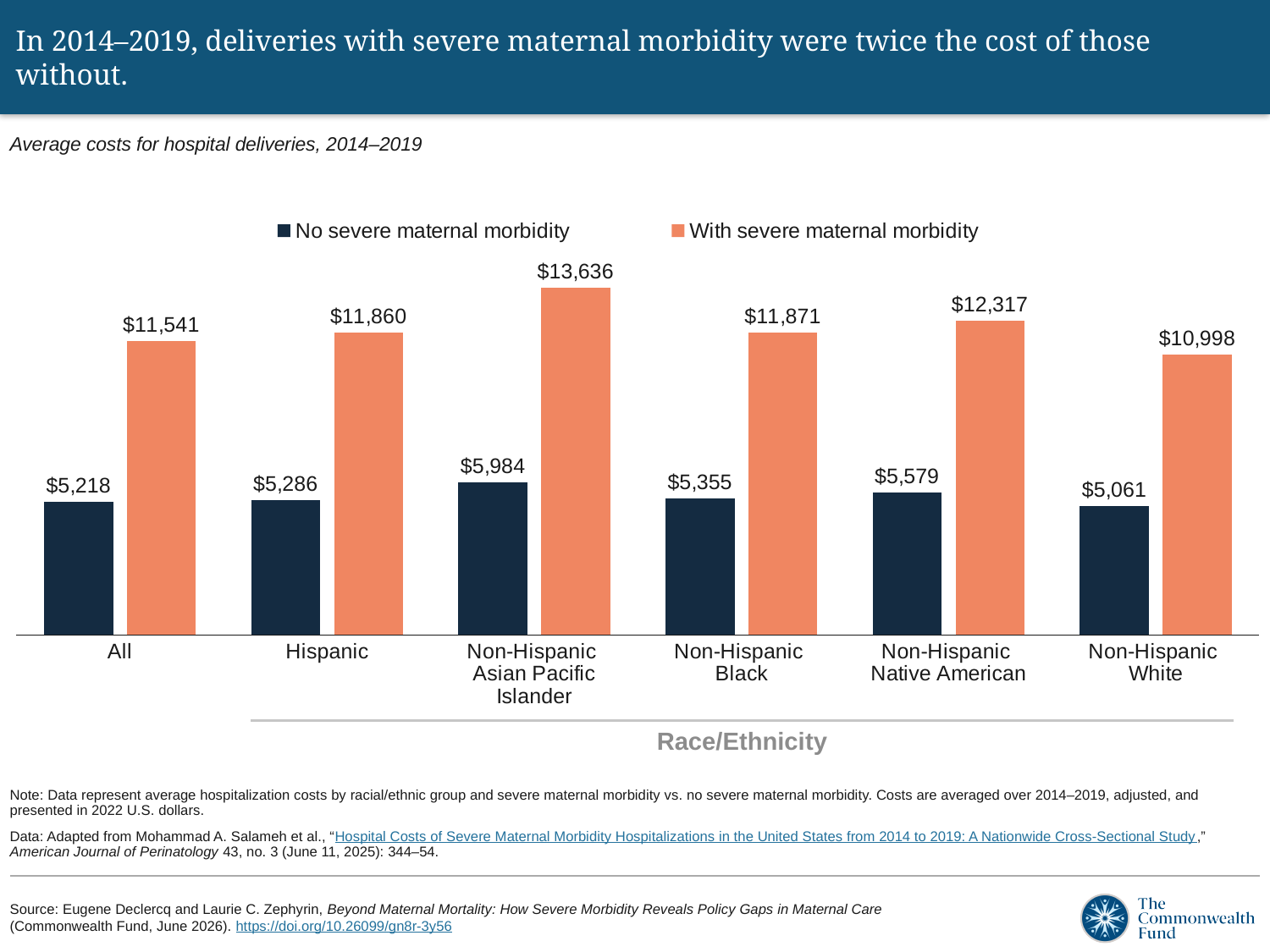
How many series does the legend list? 2 What kind of chart is shown on the slide? Bar chart Which race/ethnicity group has the lowest average cost for deliveries with no severe maternal morbidity? Non-Hispanic White What is the difference between the cost with and without severe maternal morbidity for the All category? $6,323 What is the average cost for deliveries with severe maternal morbidity for the All category? $11,541 How many race/ethnicity categories are shown on the x axis? 6 Which race/ethnicity group has the highest average cost for deliveries with severe maternal morbidity? Non-Hispanic Asian Pacific Islander What is the label of the x axis? Race/Ethnicity What is the average cost for deliveries with no severe maternal morbidity among Non-Hispanic Black patients? $5,355 What is the average cost for deliveries with severe maternal morbidity among Non-Hispanic Native American patients? $12,317 Which is larger: the cost with severe maternal morbidity for Non-Hispanic Native American deliveries or for Non-Hispanic White deliveries? Non-Hispanic Native American What is the difference between the cost with and without severe maternal morbidity for Non-Hispanic Asian Pacific Islander deliveries? $7,652